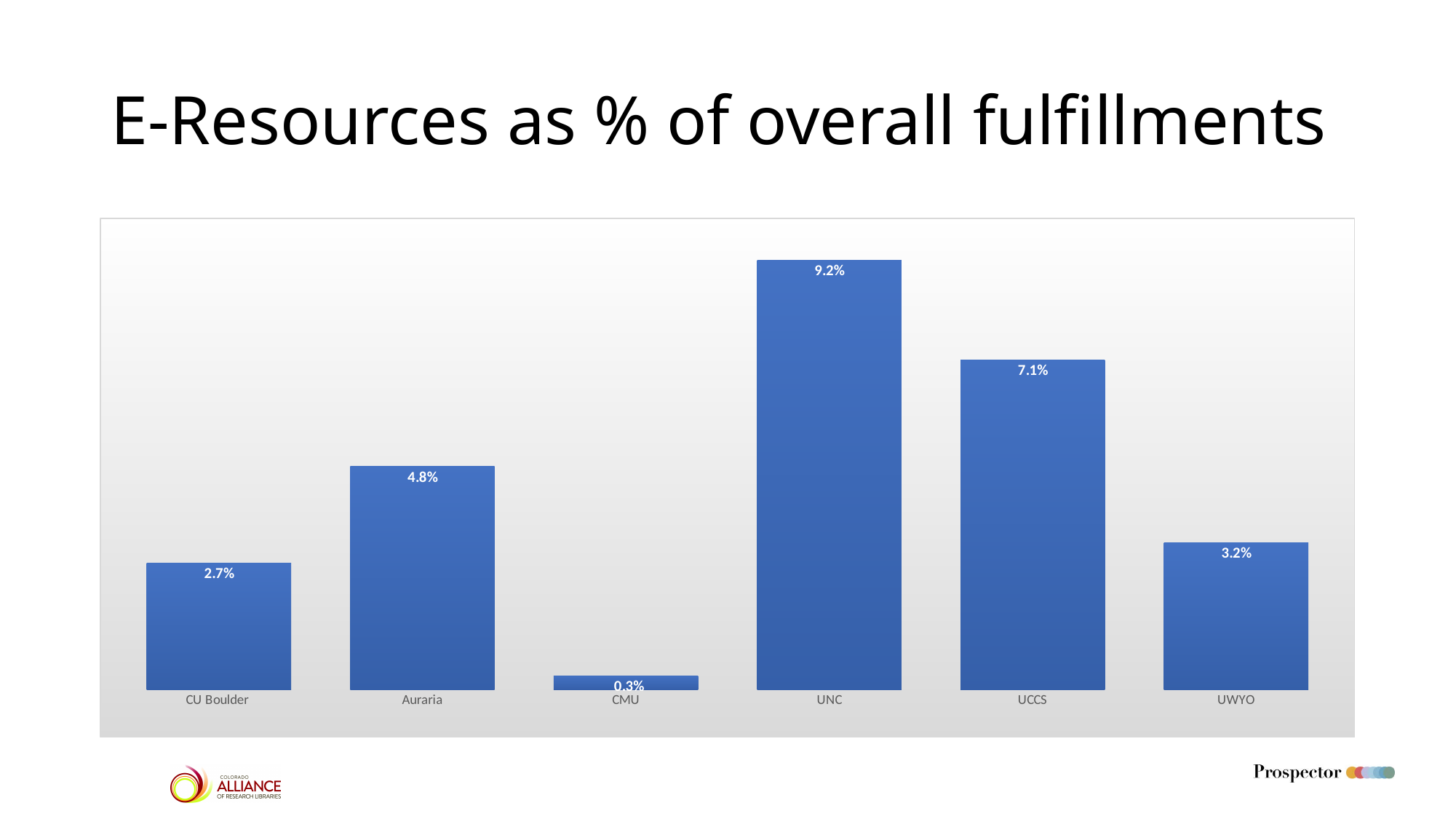
What is the value for UWYO? 3.2% What is the difference between the values for UNC and UCCS? 2.1% What is the title of the slide? E-Resources as % of overall fulfillments What is the value for CU Boulder? 2.7% What is the value for UNC? 9.2% Which category has the lowest value? CMU Which is larger, the value for UWYO or the value for Auraria? Auraria What kind of chart is shown on the slide? Bar chart What is the difference between the values for Auraria and CU Boulder? 2.1% How many categories are shown in the chart? 6 Which category has the highest value? UNC What is the value for Auraria? 4.8%